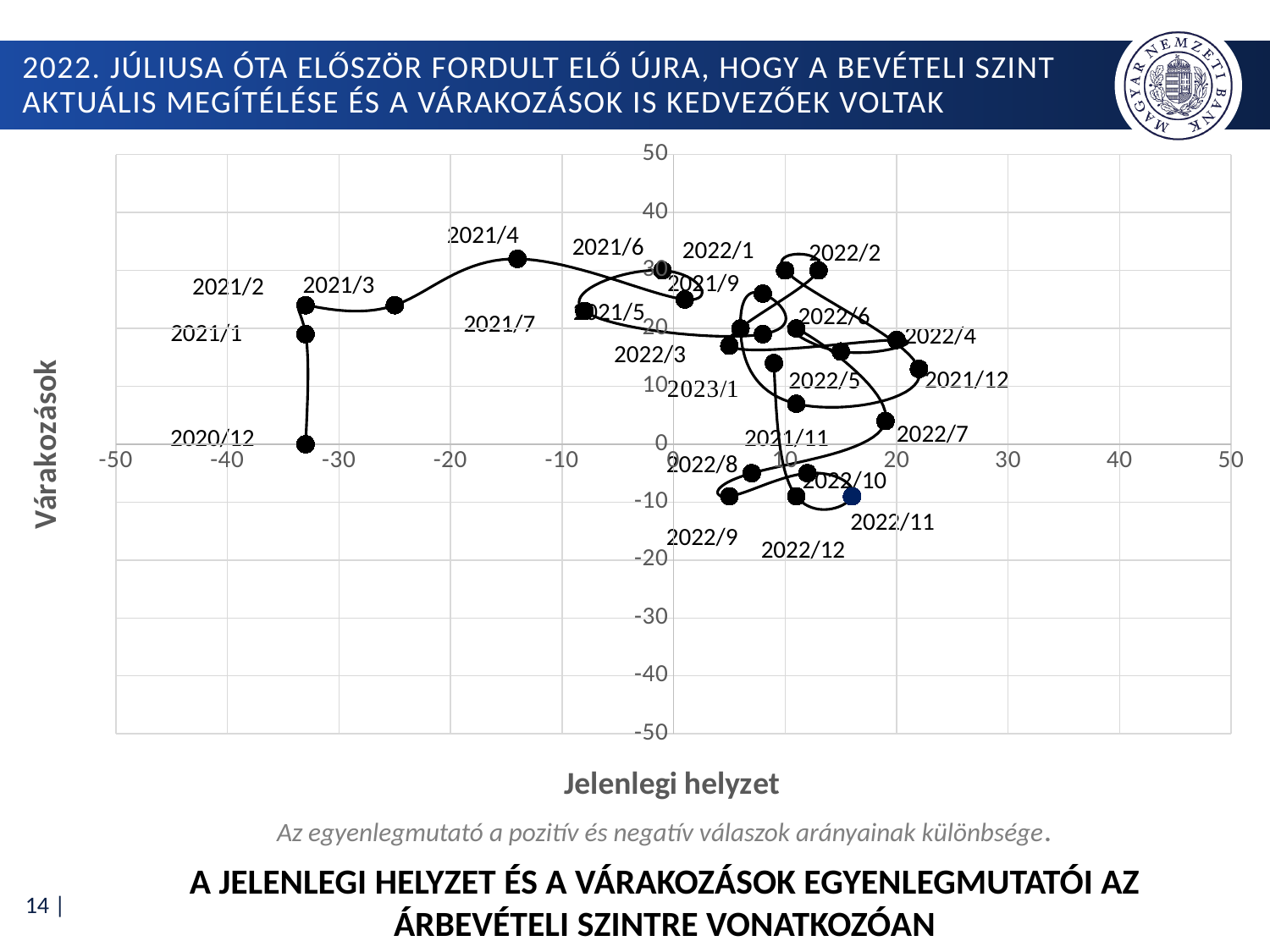
Is the Várakozások value for 2020/12 greater or less than 10? less What is the title of the vertical axis of the chart? Várakozások What kind of chart is shown on the slide? scatter chart Is the Jelenlegi helyzet value for 2021/4 greater or less than -10? less Which point has the higher Várakozások value, 2020/12 or 2021/4? 2021/4 Is the Jelenlegi helyzet value for 2020/12 greater or less than -20? less Which point has the higher Jelenlegi helyzet value, 2021/1 or 2022/11? 2022/11 What is the title of the horizontal axis of the chart? Jelenlegi helyzet